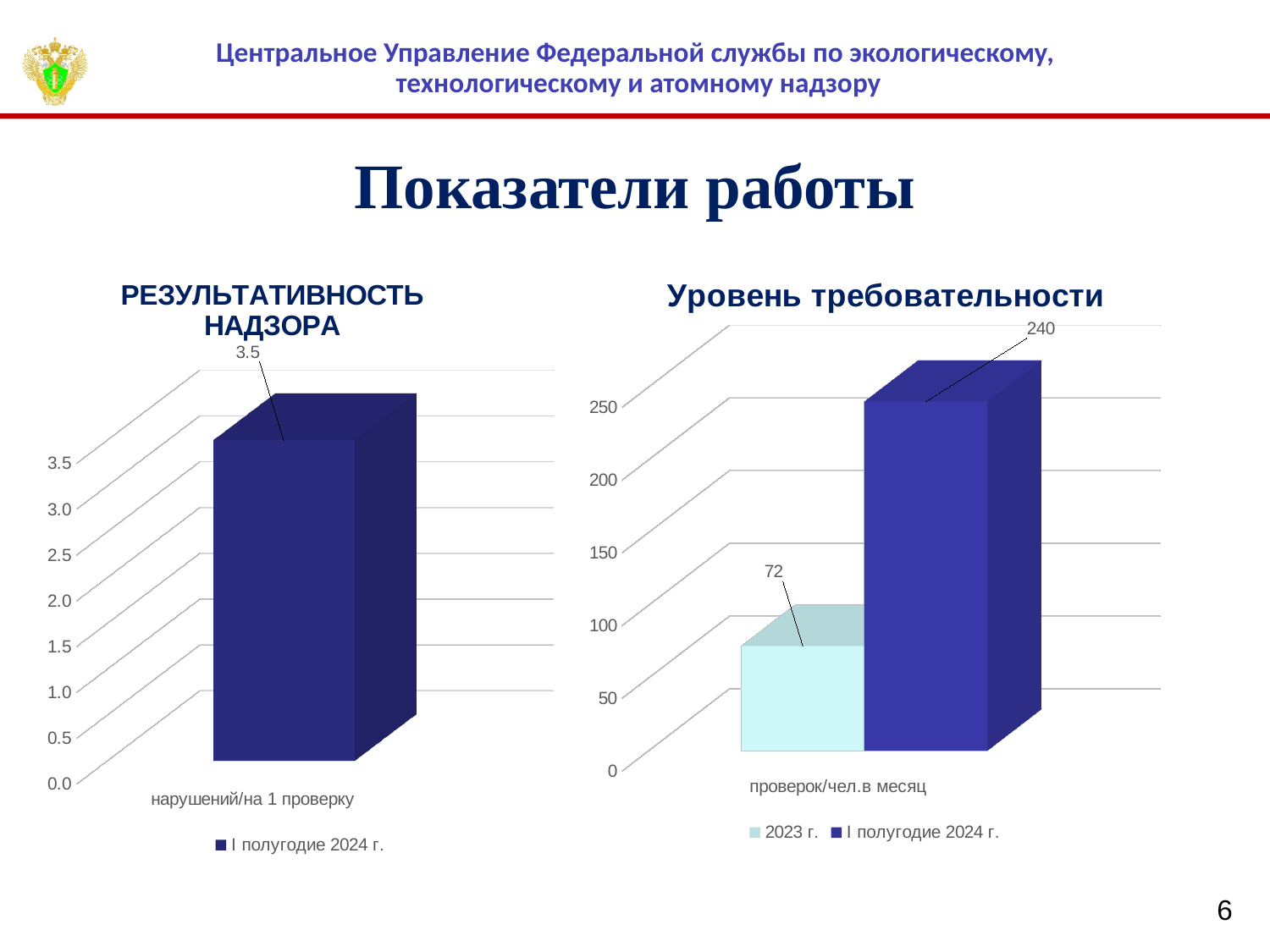
In the 'РЕЗУЛЬТАТИВНОСТЬ НАДЗОРА' chart, what is the value for 'I полугодие 2024 г.' (нарушений/на 1 проверку)? 3.5 In the 'Уровень требовательности' chart, what is the value for '2023 г.'? 72 In the 'Уровень требовательности' chart, what is the difference between the 'I полугодие 2024 г.' value and the '2023 г.' value? 168 What kind of chart is the 'Уровень требовательности' chart? Bar chart In the 'Уровень требовательности' chart, which series has the higher value, '2023 г.' or 'I полугодие 2024 г.'? I полугодие 2024 г. In the 'Уровень требовательности' chart, is the value for 'I полугодие 2024 г.' greater or less than 200? greater How many series does the legend of the 'Уровень требовательности' chart list? 2 How many series does the legend of the 'РЕЗУЛЬТАТИВНОСТЬ НАДЗОРА' chart list? 1 In the 'Уровень требовательности' chart, what is the value for 'I полугодие 2024 г.'? 240 What is the category label on the x axis of the 'Уровень требовательности' chart? проверок/чел.в месяц In the 'Уровень требовательности' chart, is the value for '2023 г.' greater or less than 100? less What is the category label on the x axis of the 'РЕЗУЛЬТАТИВНОСТЬ НАДЗОРА' chart? нарушений/на 1 проверку